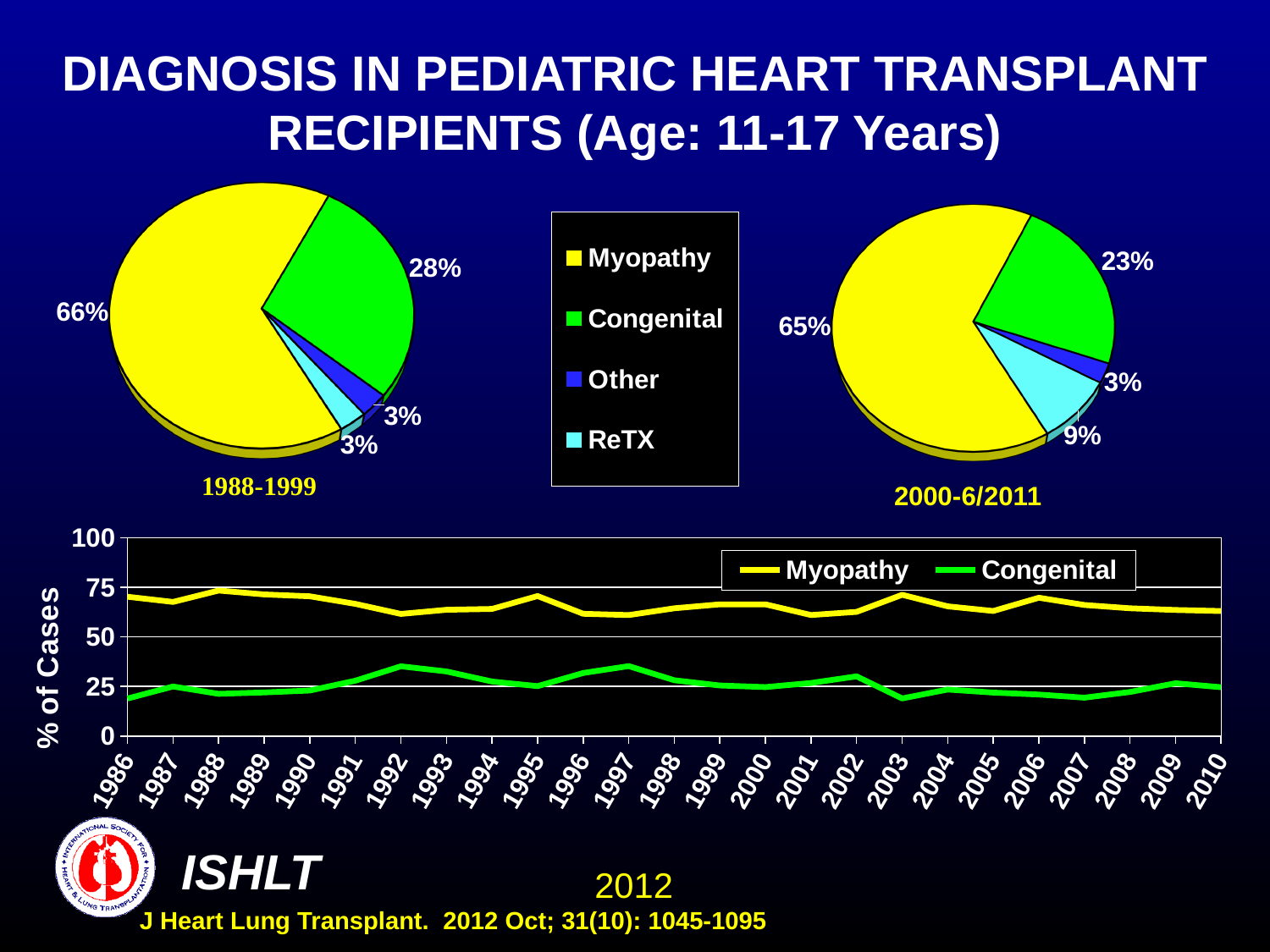
In the 1988-1999 pie chart, what share of cases is Myopathy? 66% In the line chart at the bottom, is the Congenital value for 2003 greater or less than 25? less In the 2000-6/2011 pie chart, what share of cases is ReTX? 9% What kind of chart is the chart at the bottom of the slide? Line chart In the 2000-6/2011 pie chart, which diagnosis has the largest share? Myopathy In the 1988-1999 pie chart, what share of cases is Congenital? 28% In the 2000-6/2011 pie chart, what share of cases is Congenital? 23% Which is larger: the ReTX share in the 1988-1999 pie chart or the ReTX share in the 2000-6/2011 pie chart? 2000-6/2011 In the line chart at the bottom, is the Myopathy value for 1988 greater or less than 50? greater How many series does the legend of the line chart at the bottom list? 2 What is the difference between the Congenital share in the 1988-1999 pie chart and the Congenital share in the 2000-6/2011 pie chart? 5% How many years are shown on the x axis of the line chart at the bottom? 25